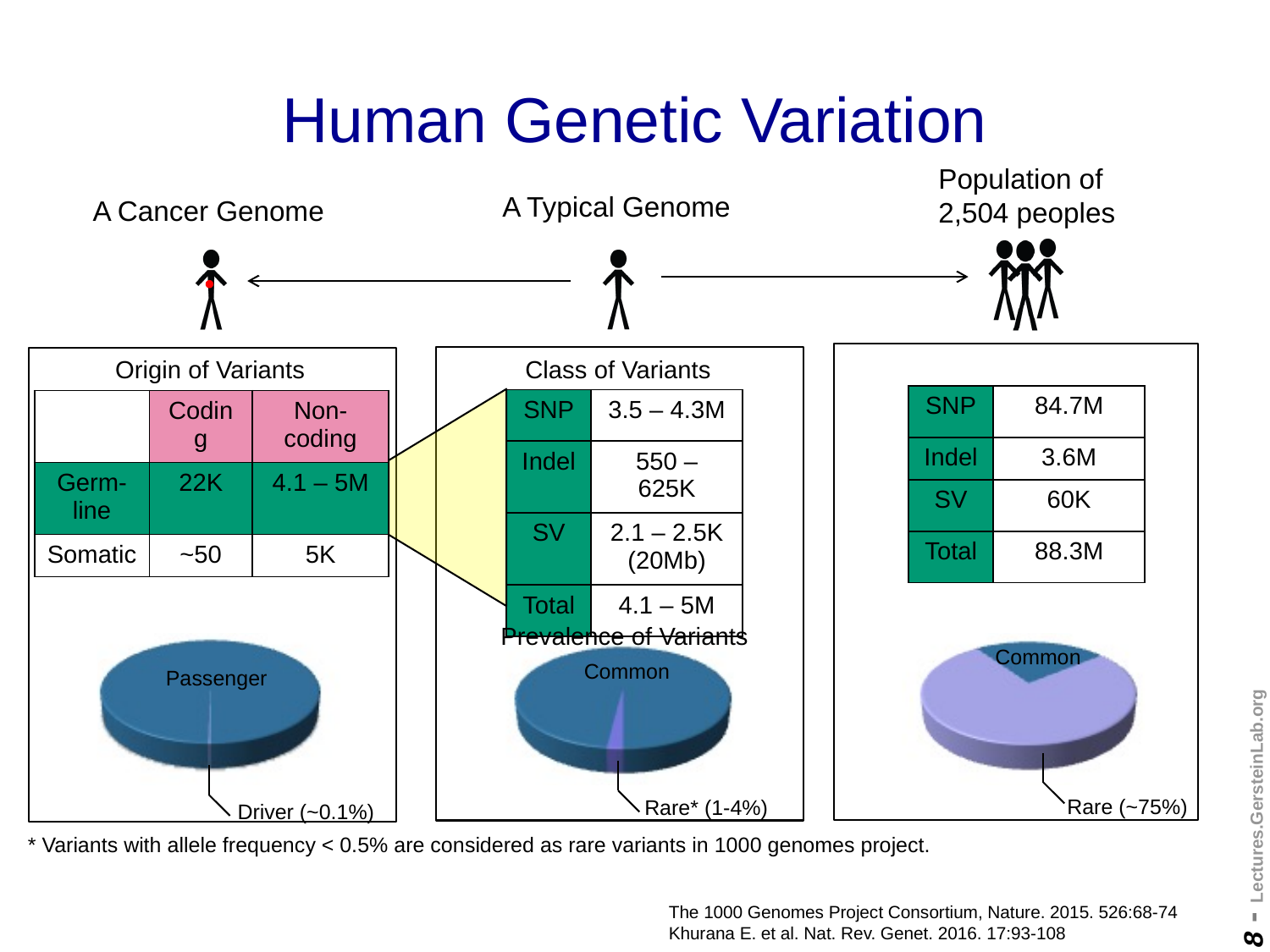
What kind of chart is shown under 'Prevalence of Variants' in the middle of the slide? pie chart In the middle pie chart (A Typical Genome), which slice is the smallest? Rare In the middle pie chart (A Typical Genome), how many slices are there? 2 In the left pie chart (A Cancer Genome), how many slices are there? 2 In the left pie chart (A Cancer Genome), which slice is the smallest? Driver What kind of chart is shown under 'A Cancer Genome' on the left of the slide? pie chart In the left pie chart (A Cancer Genome), what is the label on the small slice? Driver (~0.1%) In the middle pie chart (A Typical Genome), which slice is larger, Common or Rare? Common In the left pie chart (A Cancer Genome), which slice is the largest? Passenger In the right pie chart (Population of 2,504 peoples), which slice is the largest? Rare In the right pie chart (Population of 2,504 peoples), which slice is larger, Common or Rare? Rare In the right pie chart (Population of 2,504 peoples), what is the label on the large slice? Rare (~75%)